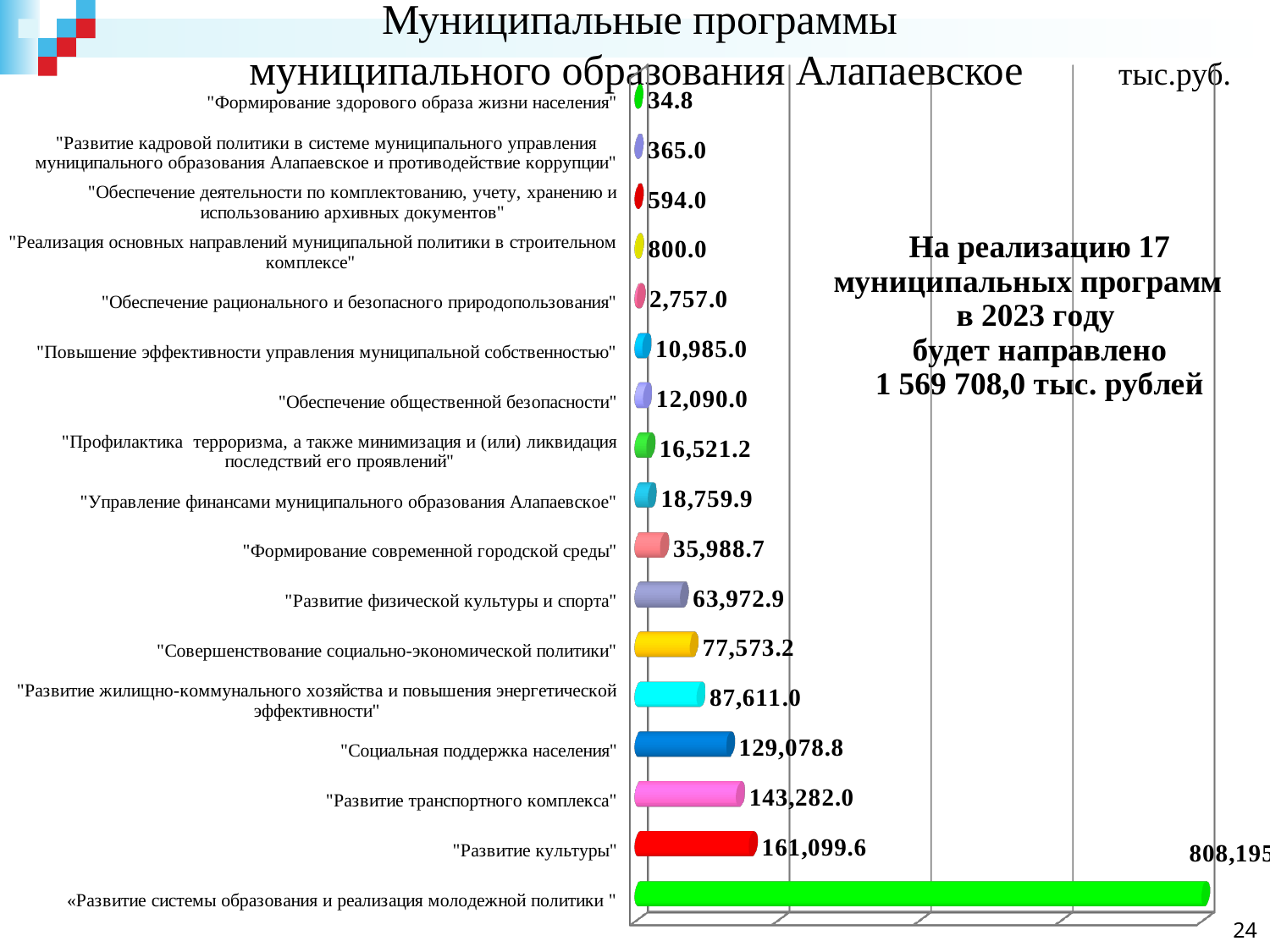
What is the difference between the values for "Развитие культуры" and "Развитие транспортного комплекса"? 17,817.6 Which is larger: the value for "Развитие физической культуры и спорта" or for "Совершенствование социально-экономической политики"? "Совершенствование социально-экономической политики" What is the value for "Социальная поддержка населения"? 129,078.8 What is the value for "Развитие культуры"? 161,099.6 Which programme has the highest value in the chart? «Развитие системы образования и реализация молодежной политики» How many municipal programmes (categories) are plotted in the chart? 17 What is the value for "Обеспечение общественной безопасности"? 12,090.0 What is the value for "Формирование современной городской среды"? 35,988.7 Which programme has the lowest value in the chart? "Формирование здорового образа жизни населения" According to the text on the slide, what total amount will be directed to the 17 municipal programmes in 2023? 1 569 708,0 тыс. рублей What kind of chart is shown on the slide? bar chart In what units are the chart values given, according to the label at the top right of the chart? тыс.руб.